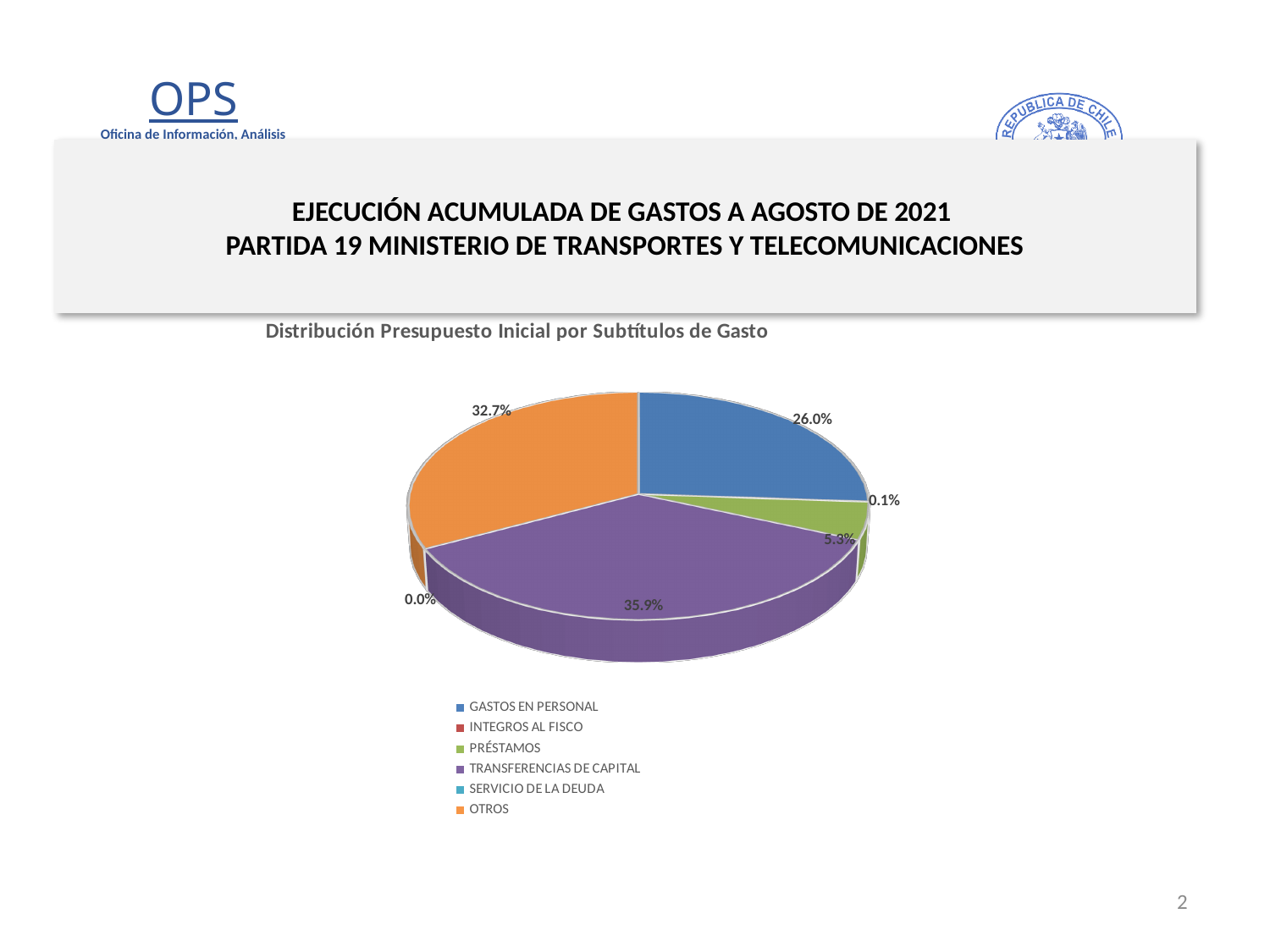
What kind of chart is shown on the slide? Pie chart What is the difference in percentage points between GASTOS EN PERSONAL and PRÉSTAMOS? 20.7 percentage points What share of the pie does GASTOS EN PERSONAL represent? 26.0% What share of the pie does SERVICIO DE LA DEUDA represent? 0.0% What share of the pie does TRANSFERENCIAS DE CAPITAL represent? 35.9% Which is larger, the share for OTROS or the share for GASTOS EN PERSONAL? OTROS What share of the pie does OTROS represent? 32.7% How many categories does the legend list? 6 What share of the pie does PRÉSTAMOS represent? 5.3% What is the title of the chart? Distribución Presupuesto Inicial por Subtítulos de Gasto What is the difference in percentage points between TRANSFERENCIAS DE CAPITAL and OTROS? 3.2 percentage points Which category has the largest share of the pie? TRANSFERENCIAS DE CAPITAL